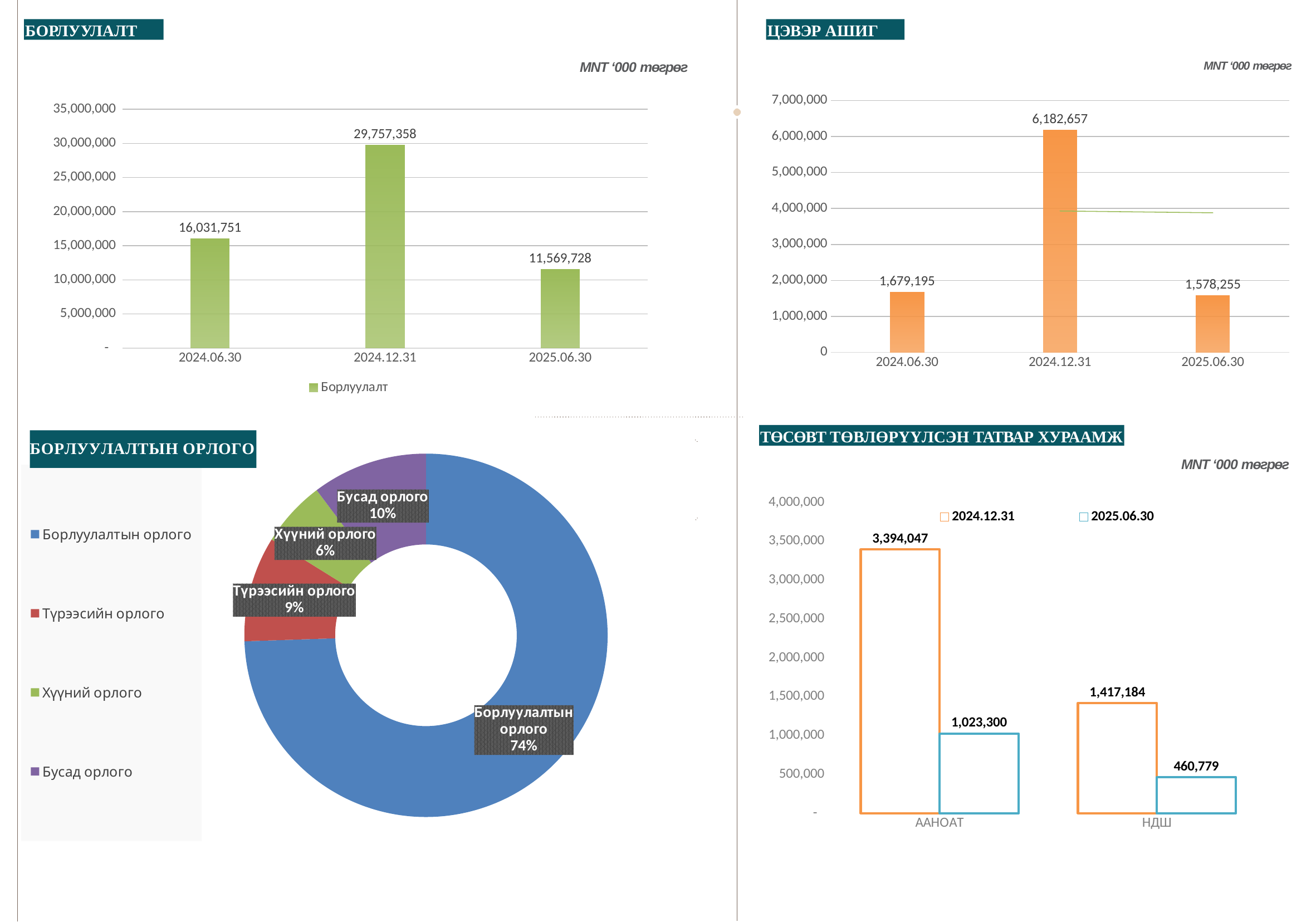
In the БОРЛУУЛАЛТЫН ОРЛОГО chart, which category has the largest share? Борлуулалтын орлого In the БОРЛУУЛАЛТЫН ОРЛОГО chart, what share does Түрээсийн орлого have? 9% In the ТӨСӨВТ ТӨВЛӨРҮҮЛСЭН ТАТВАР ХУРААМЖ chart, which is larger for НДШ: the 2024.12.31 value or the 2025.06.30 value? 2024.12.31 In the ТӨСӨВТ ТӨВЛӨРҮҮЛСЭН ТАТВАР ХУРААМЖ chart, how many series does the legend list? 2 In the ТӨСӨВТ ТӨВЛӨРҮҮЛСЭН ТАТВАР ХУРААМЖ chart, what is the 2025.06.30 value for ААНОАТ? 1,023,300 In the ЦЭВЭР АШИГ chart, how many periods are shown on the x axis? 3 What kind of chart is the БОРЛУУЛАЛТЫН ОРЛОГО chart? Doughnut (pie) chart In the БОРЛУУЛАЛТ chart, what is the value for 2024.12.31? 29,757,358 In the БОРЛУУЛАЛТ chart, what is the difference between the 2024.06.30 and 2025.06.30 values? 4,462,023 In the БОРЛУУЛАЛТ chart, which period has the lowest value? 2025.06.30 In the ЦЭВЭР АШИГ chart, which period has the highest value? 2024.12.31 In the ЦЭВЭР АШИГ chart, what is the value for 2024.12.31? 6,182,657